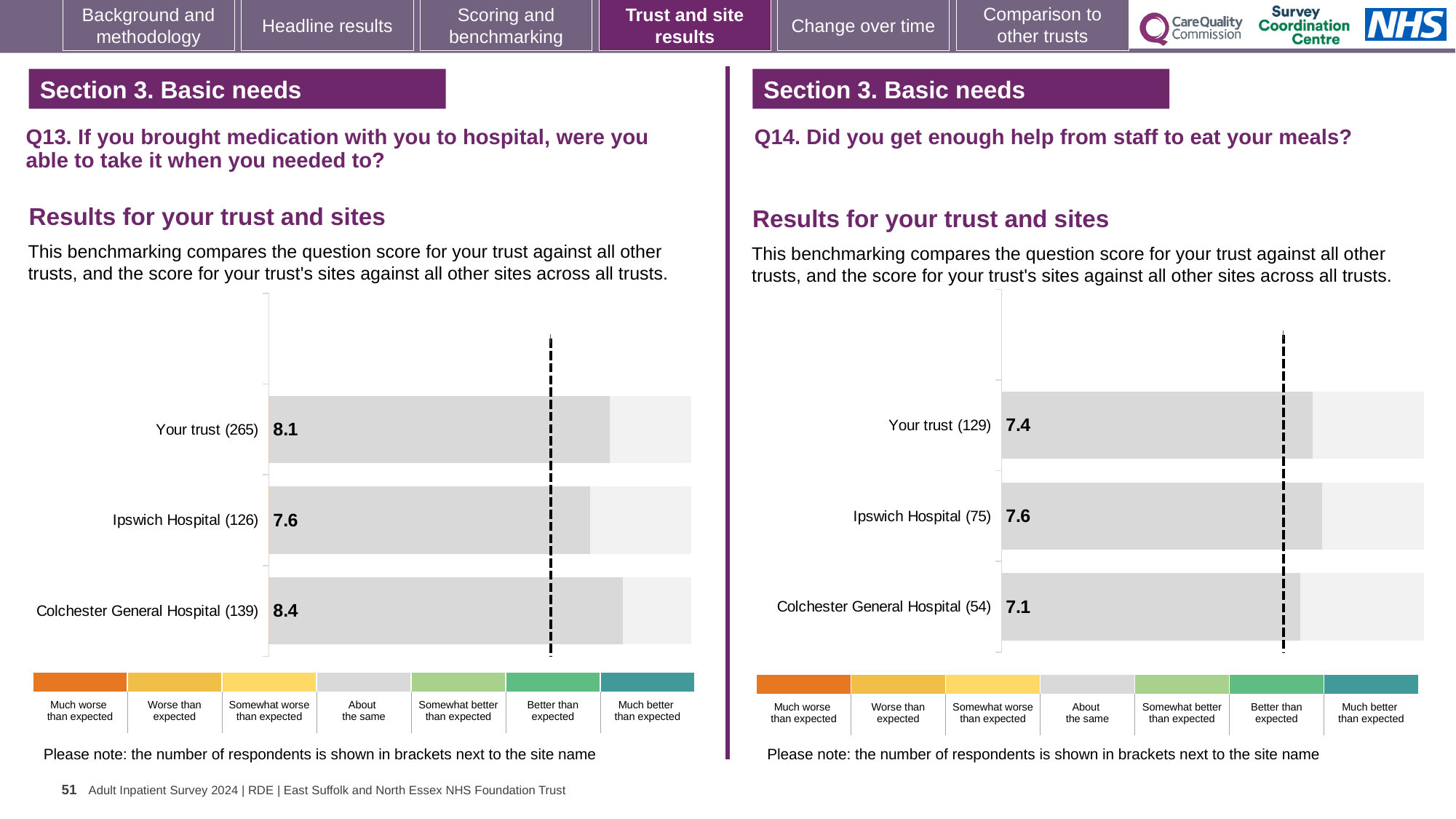
In the Q13 chart (left), which site or trust has the lowest score? Ipswich Hospital What kind of chart is used for the Q14 results (right)? Bar chart In the Q13 chart (left), what is the difference between the scores for Colchester General Hospital and Ipswich Hospital? 0.8 In the Q14 chart (right), which site or trust has the highest score? Ipswich Hospital In the Q13 chart (left), what is the score for Your trust? 8.1 In the Q14 chart (right), what is the difference between the scores for Ipswich Hospital and Colchester General Hospital? 0.5 In the Q13 chart (left), what is the score for Colchester General Hospital? 8.4 In the Q14 chart (right), what is the score for Your trust? 7.4 In the Q14 chart (right), which has the larger score, Your trust or Colchester General Hospital? Your trust In the Q13 chart (left), how many respondents are shown for Ipswich Hospital? 126 How many bars are plotted in the Q13 chart (left)? 3 In the Q14 chart (right), how many respondents are shown for Colchester General Hospital? 54